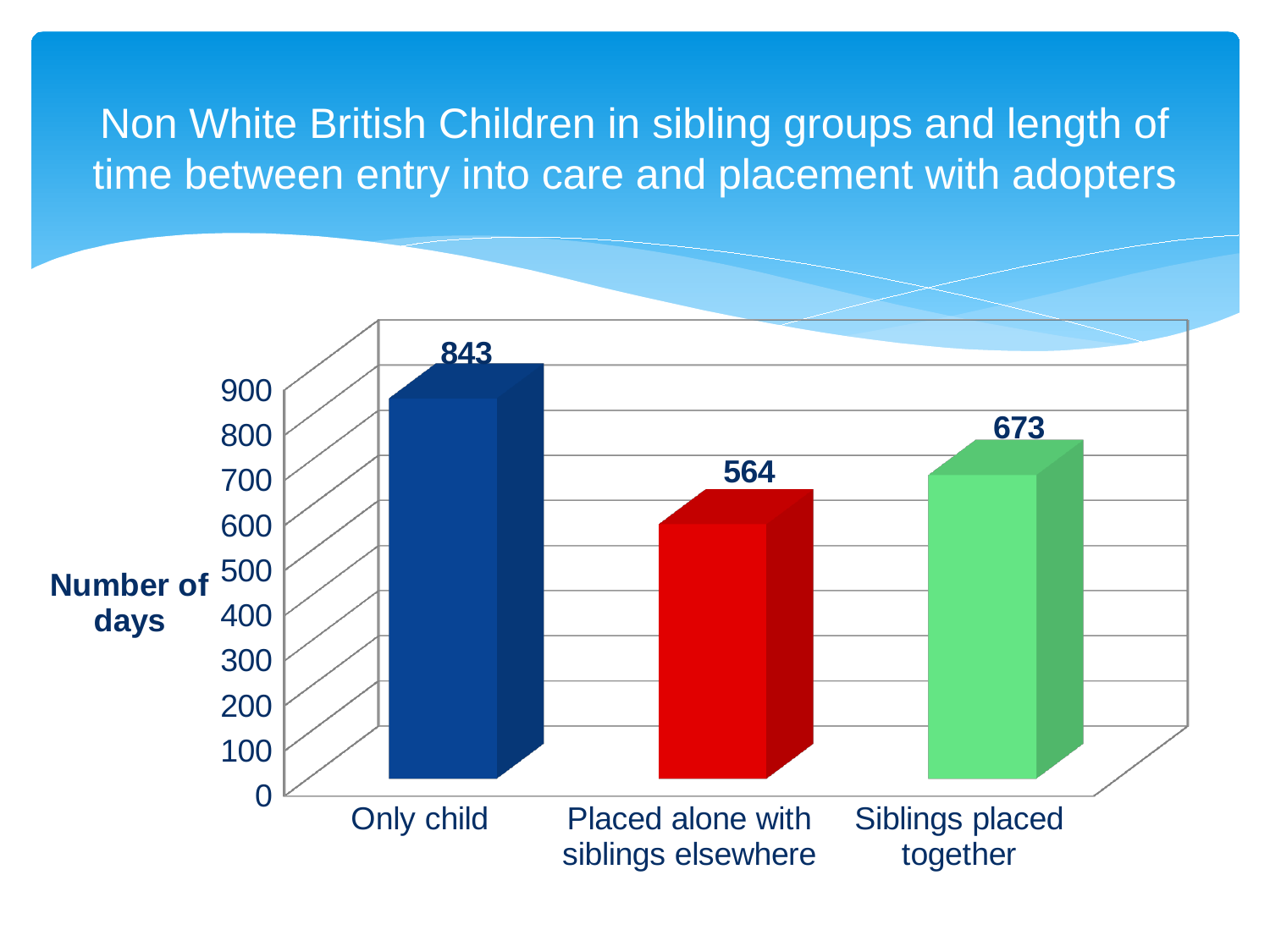
What is the number of days for Siblings placed together? 673 Which category has the lowest number of days? Placed alone with siblings elsewhere What is the difference in number of days between Siblings placed together and Placed alone with siblings elsewhere? 109 How many categories are shown on the chart? 3 What is the difference in number of days between Only child and Placed alone with siblings elsewhere? 279 What is the number of days for Only child? 843 Is the value for Siblings placed together greater or less than 600? greater Which has more days: Siblings placed together or Placed alone with siblings elsewhere? Siblings placed together What is the number of days for Placed alone with siblings elsewhere? 564 Which category has the highest number of days? Only child What kind of chart is shown on the slide? Bar chart What is the label on the vertical axis of the chart? Number of days